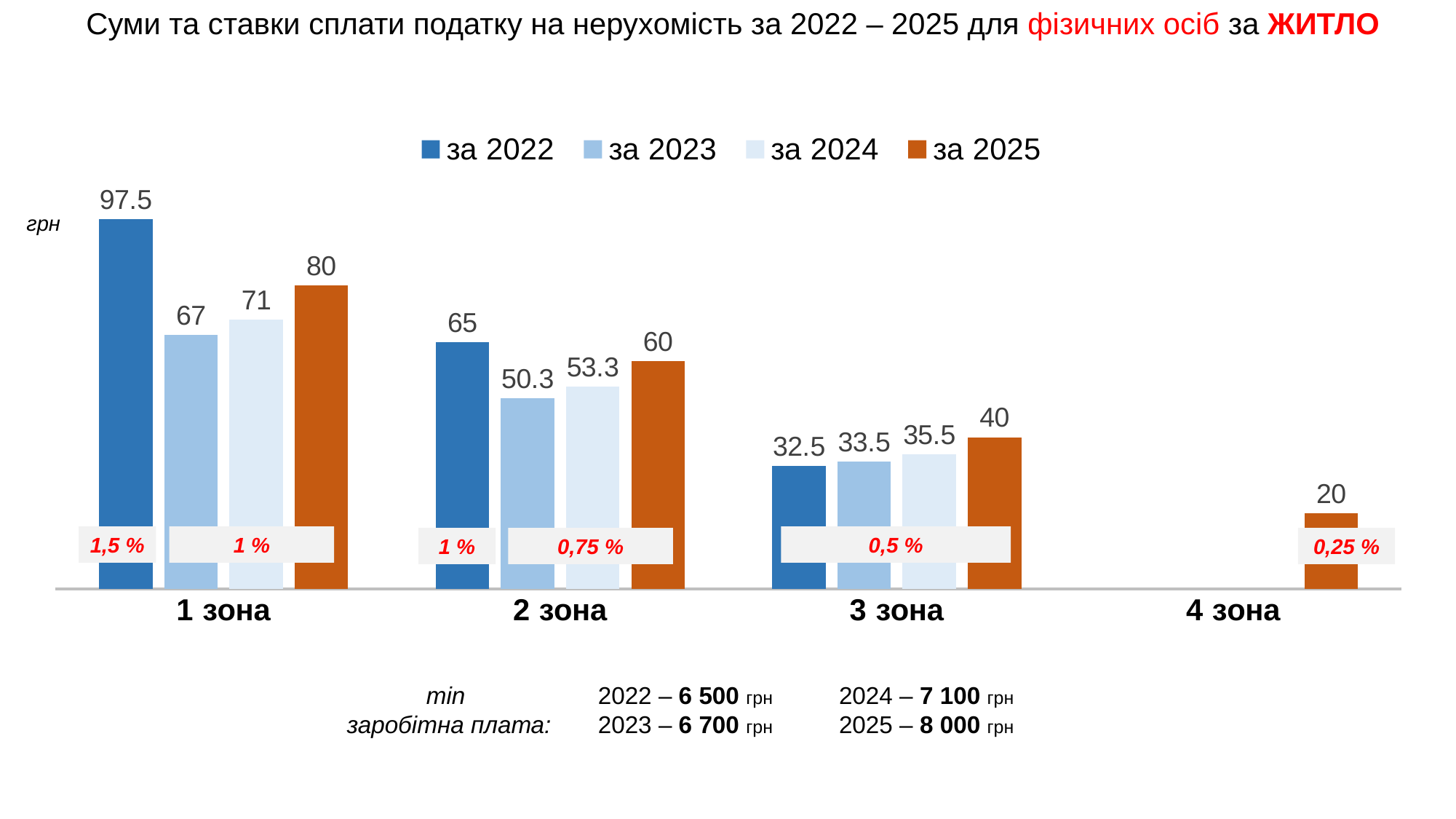
Which zone has the lowest value for "за 2025"? 4 зона What is the value for "за 2022" in "1 зона"? 97.5 What kind of chart is shown on the slide? bar chart Which is larger in "2 зона": the value for "за 2022" or the value for "за 2025"? за 2022 What is the value for "за 2025" in "4 зона"? 20 Which zone has the highest value for "за 2022"? 1 зона What is the difference between the "за 2025" and "за 2024" values in "1 зона"? 9 What is the value for "за 2025" in "3 зона"? 40 What is the value for "за 2023" in "2 зона"? 50.3 How many zone categories are shown on the x axis? 4 What tax rate is shown for "за 2025" in "4 зона"? 0,25 % How many series does the legend list? 4